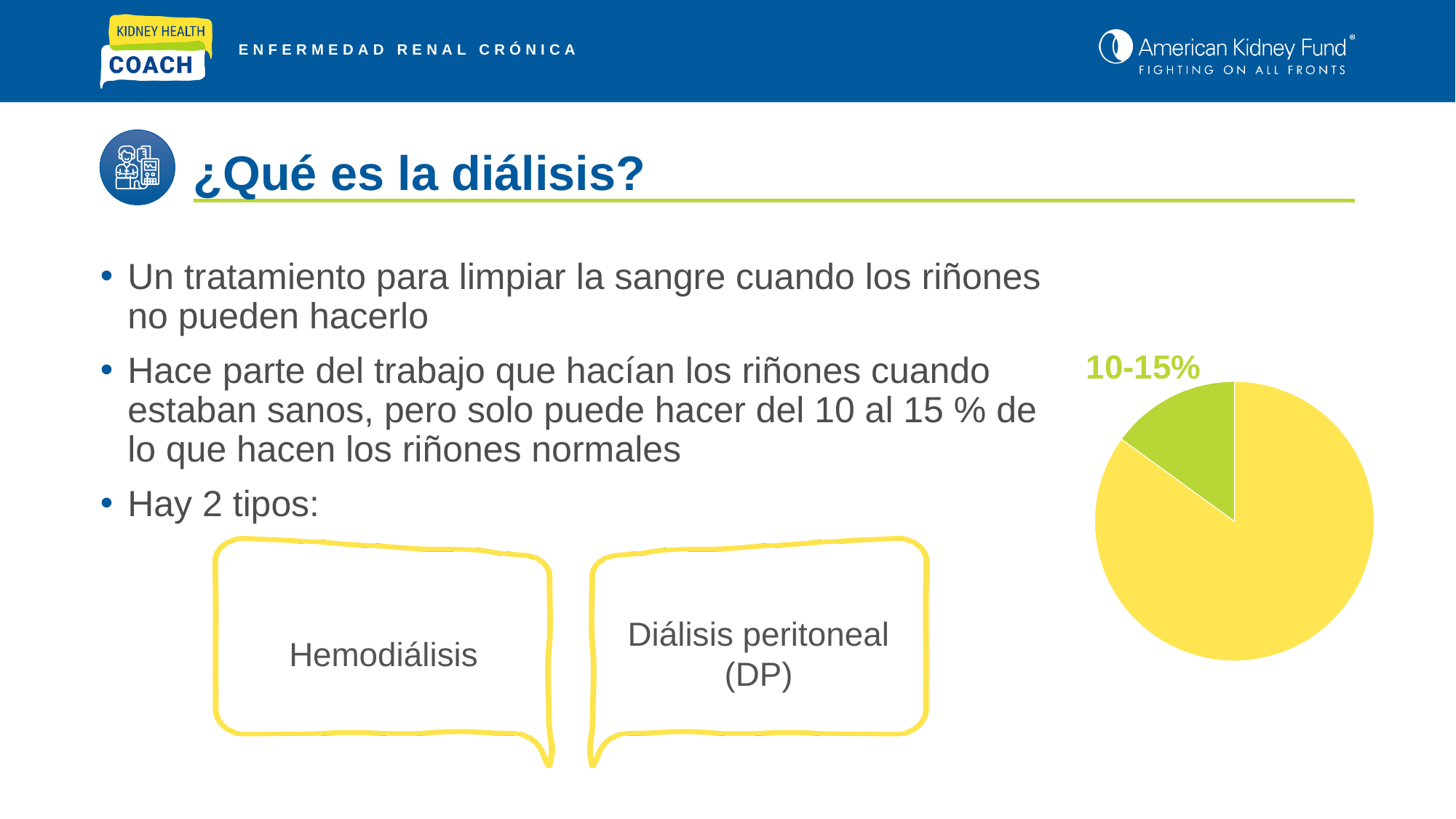
Which slice of the pie chart is the smallest? the green slice What share of the pie does the green slice represent, according to the label on the chart? 10-15% Is the yellow slice of the pie chart greater or less than 50% of the pie? greater What label is printed next to the green slice of the pie chart? 10-15% How many slices does the pie chart have? 2 Which slice of the pie chart is larger, the yellow slice or the green slice? the yellow slice What colour is the larger slice of the pie chart? yellow Does the pie chart include a legend? No What kind of chart is shown on the right side of the slide? pie chart Is the green slice of the pie chart greater or less than 50% of the pie? less